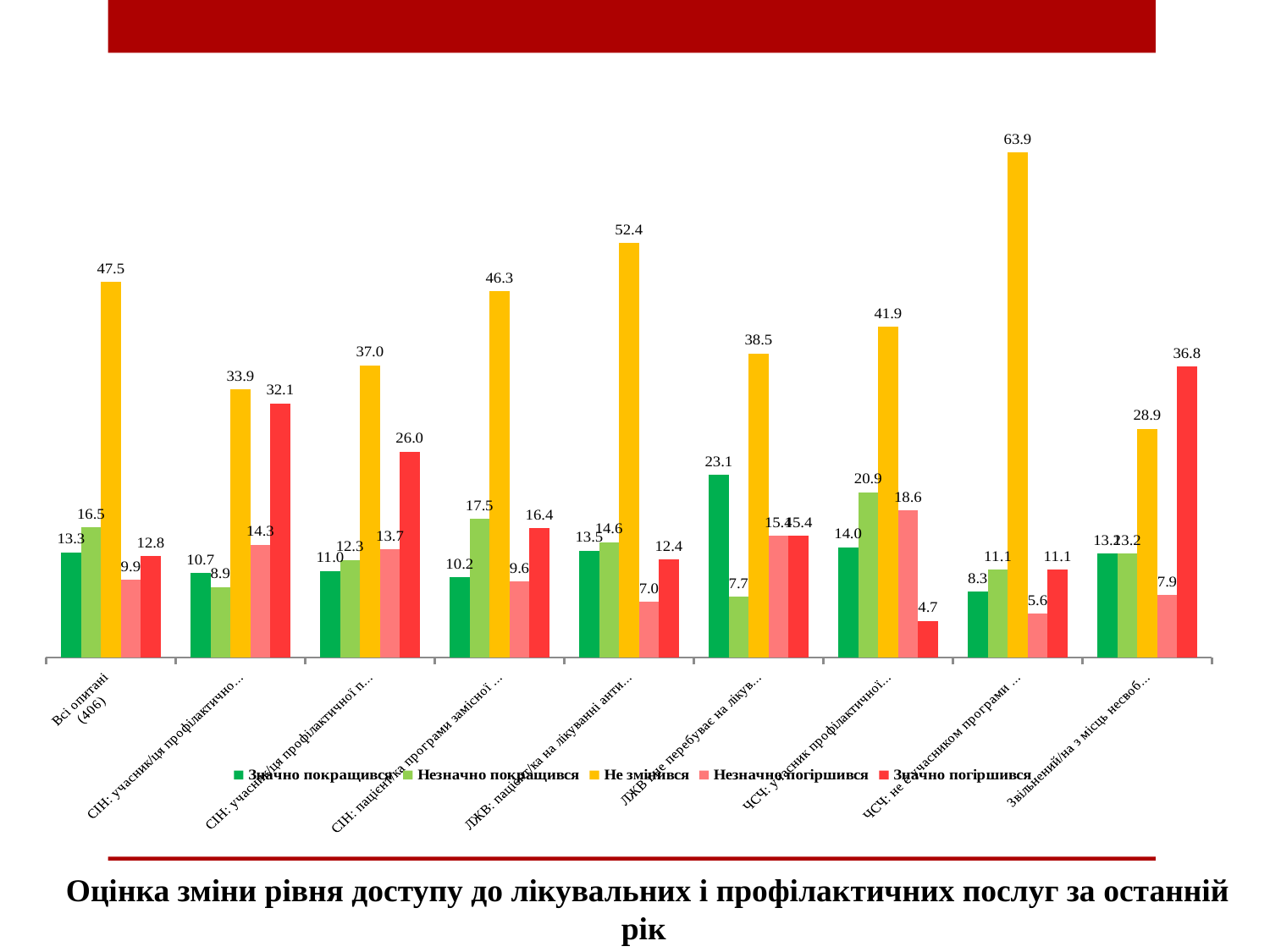
For 'Всі опитані (406)', which is larger: 'Незначно покращився' or 'Значно погіршився'? Незначно покращився What is the value of 'Не змінився' for 'Всі опитані (406)'? 47.5 What is the lowest 'Значно погіршився' value shown across all groups? 4.7 What is the highest 'Не змінився' value shown across all groups? 63.9 How many category groups are plotted along the x axis? 9 How many series does the legend list? 5 What is the value of 'Значно покращився' for 'Всі опитані (406)'? 13.3 What type of chart is shown on the slide? bar chart For 'Всі опитані (406)', what is the difference between 'Не змінився' and 'Значно покращився'? 34.2 What is the highest 'Значно погіршився' value shown across all groups? 36.8 What is the value of 'Незначно погіршився' for 'Всі опитані (406)'? 9.9 What colour represents the 'Не змінився' series? yellow